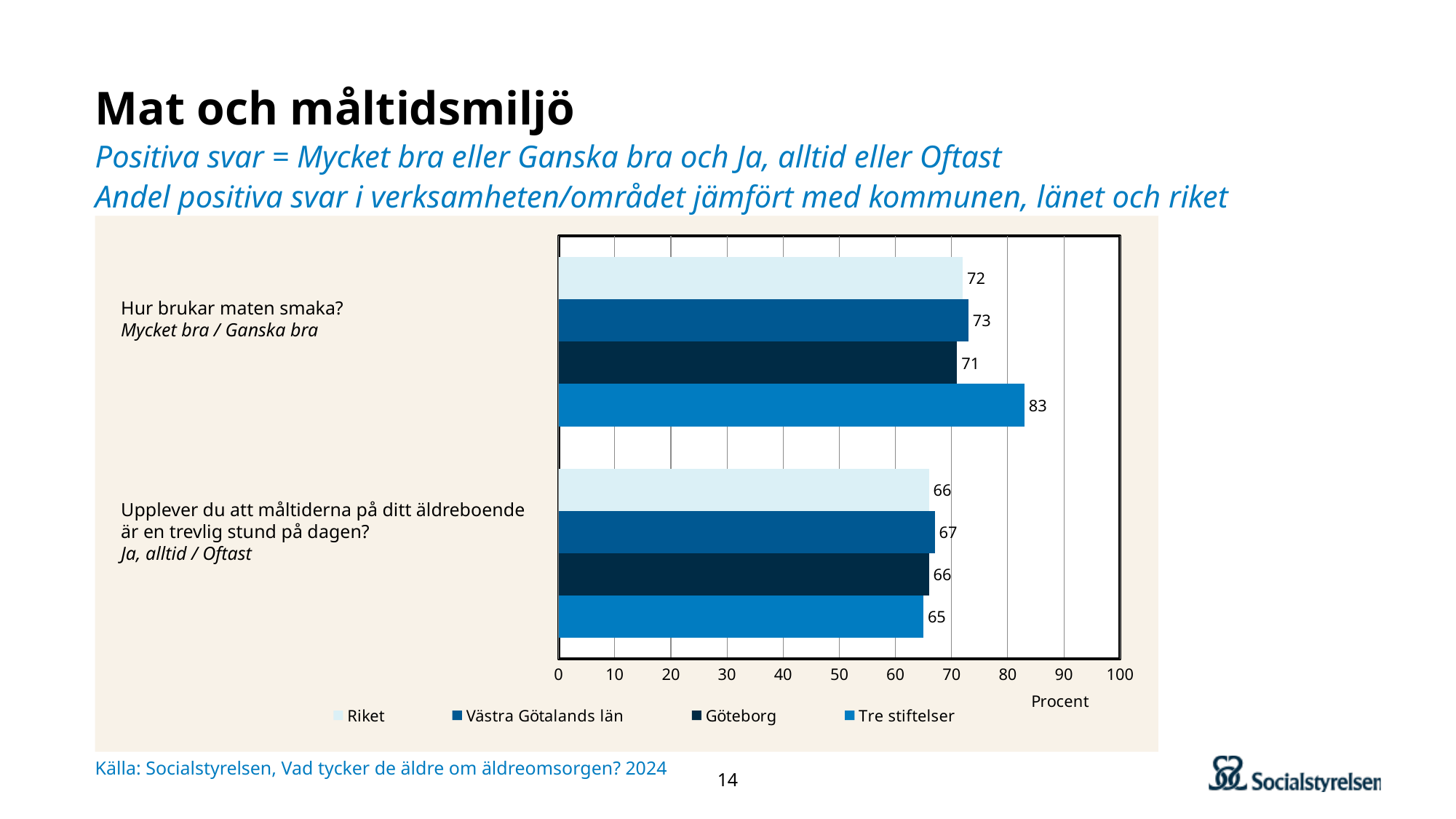
Which series has the lowest value on the question "Hur brukar maten smaka?"? Göteborg What is the value for Tre stiftelser on the question "Hur brukar maten smaka?"? 83 Is the value for Tre stiftelser on the question "Hur brukar maten smaka?" greater or less than 80? greater Which series has the highest value on the question "Hur brukar maten smaka?"? Tre stiftelser What unit is shown on the horizontal axis of the chart? Procent What is the difference between the Tre stiftelser value and the Riket value on the question "Hur brukar maten smaka?"? 11 How many series does the legend list? 4 Which is larger on the question "Hur brukar maten smaka?": the value for Tre stiftelser or the value for Göteborg? Tre stiftelser What is the value for Riket on the question "Hur brukar maten smaka?"? 72 What is the value for Västra Götalands län on the question "Upplever du att måltiderna på ditt äldreboende är en trevlig stund på dagen?"? 67 What kind of chart is shown on the slide? Bar chart What is the value for Göteborg on the question "Upplever du att måltiderna på ditt äldreboende är en trevlig stund på dagen?"? 66